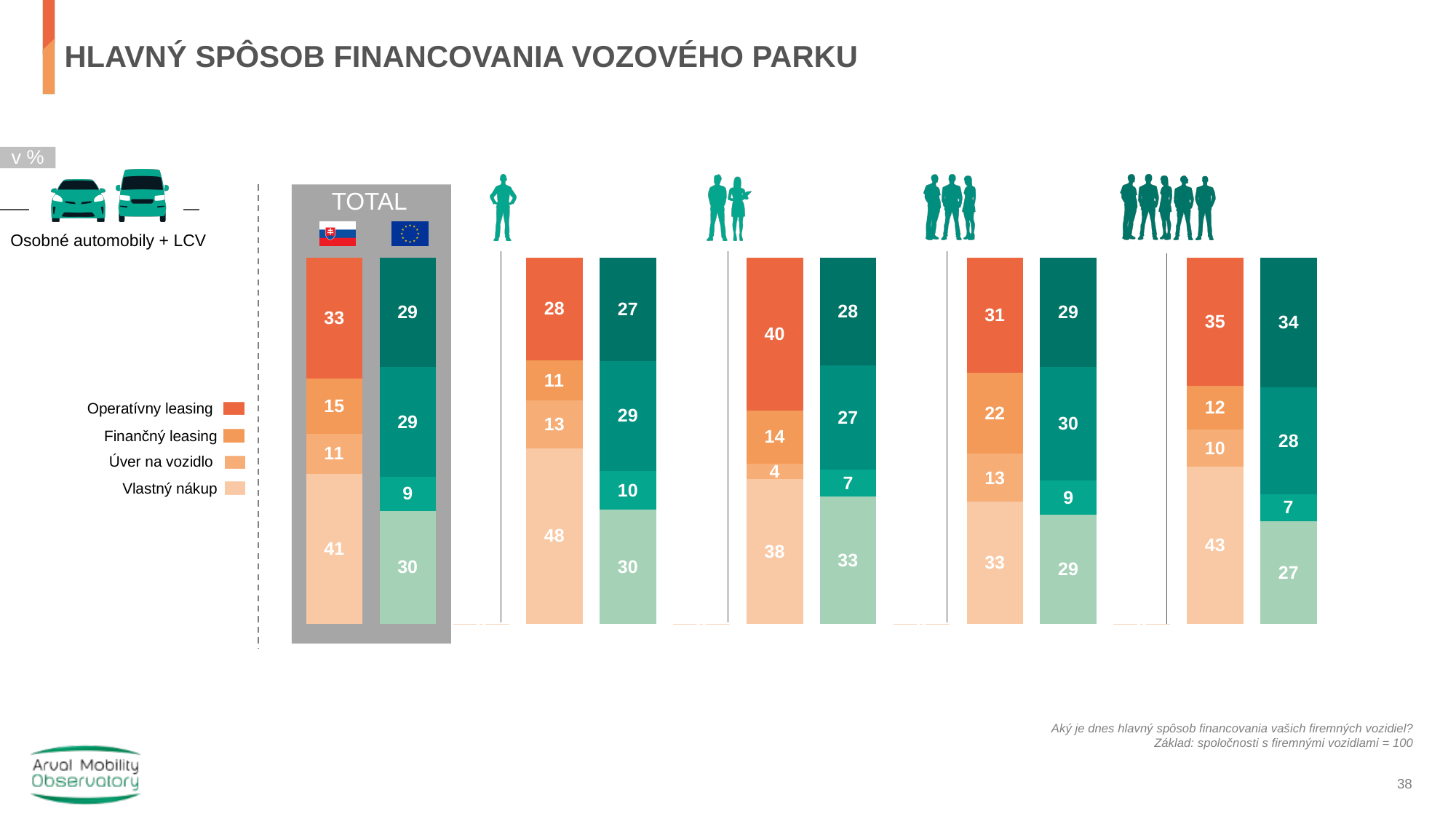
What is the total of the Slovak (flag) bar in the TOTAL column? 100 In the third group from the left (three-person icon), what is the Finančný leasing value for the EU bar? 30 Among the Slovak (orange) bars, which group has the lowest Úver na vozidlo value? The second group from the left (two-person icon), 4 In the TOTAL column, what is the Finančný leasing value for the Slovak bar? 15 How many series does the legend list? 4 In the rightmost group (five-person icon), what is the Vlastný nákup value for the Slovak (orange) bar? 43 What kind of chart is shown on the slide? Stacked bar chart Among the Slovak (orange) bars, which group has the highest Operatívny leasing value? The second group from the left (two-person icon), 40 In the TOTAL column, what is the Vlastný nákup value for the EU bar? 30 In the TOTAL column, what is the Operatívny leasing value for the Slovak (flag) bar? 33 In the TOTAL column, what is the difference between the Slovak and EU Vlastný nákup values? 11 In the TOTAL column, which bar has the larger Operatívny leasing value, the Slovak bar or the EU bar? The Slovak bar